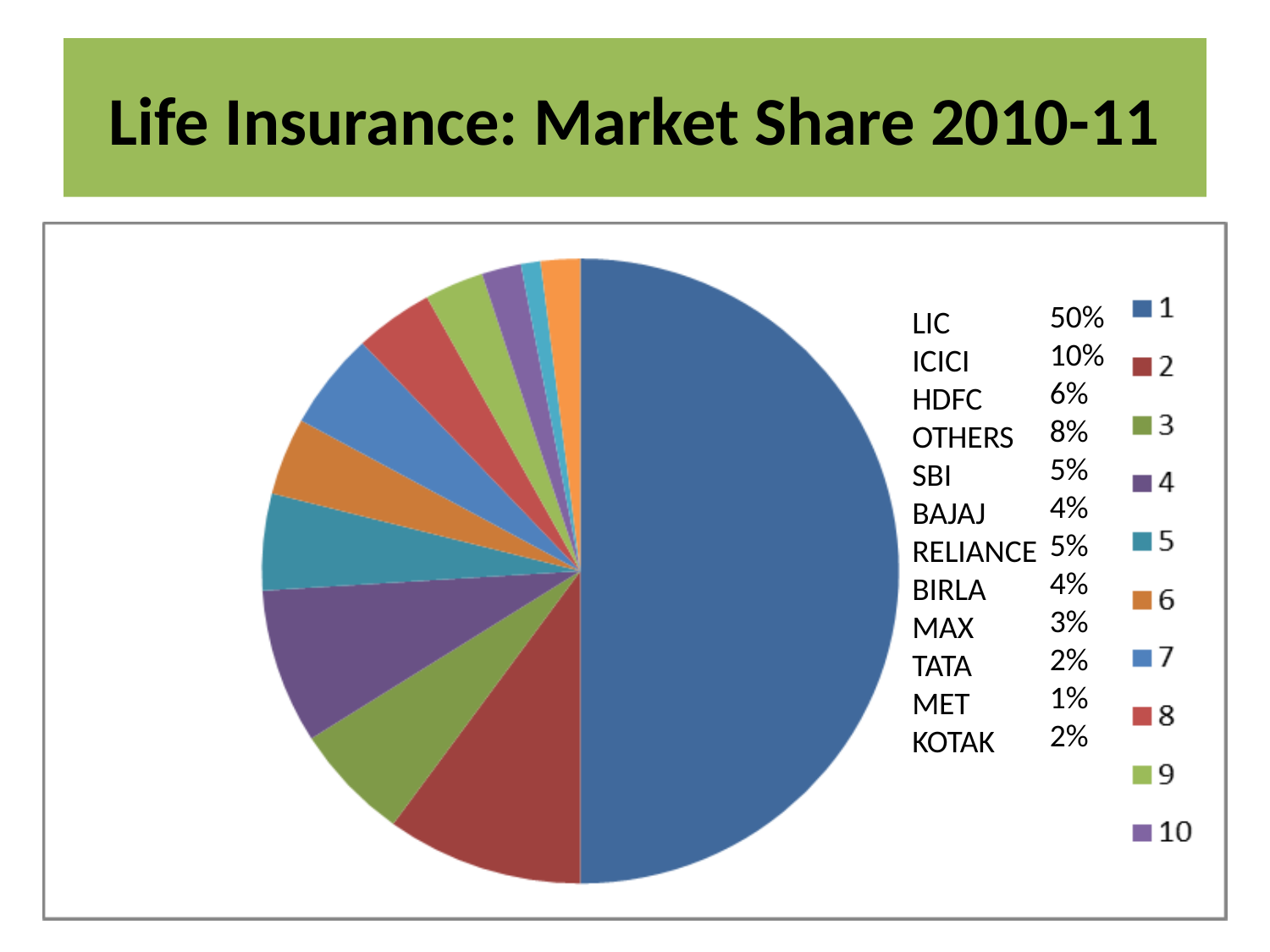
What is the combined market share of TATA and KOTAK? 4% Which has a larger market share, HDFC or SBI? HDFC What is the difference between the market shares of LIC and ICICI? 40% What market share is listed for ICICI? 10% Which company has the largest market share? LIC What market share is listed for LIC? 50% How many companies or groups are listed with a market share on the slide? 12 What is the title of the slide? Life Insurance: Market Share 2010-11 What market share is listed for OTHERS? 8% What kind of chart is shown on the slide? pie chart Which company has the smallest market share? MET What market share is listed for MET? 1%